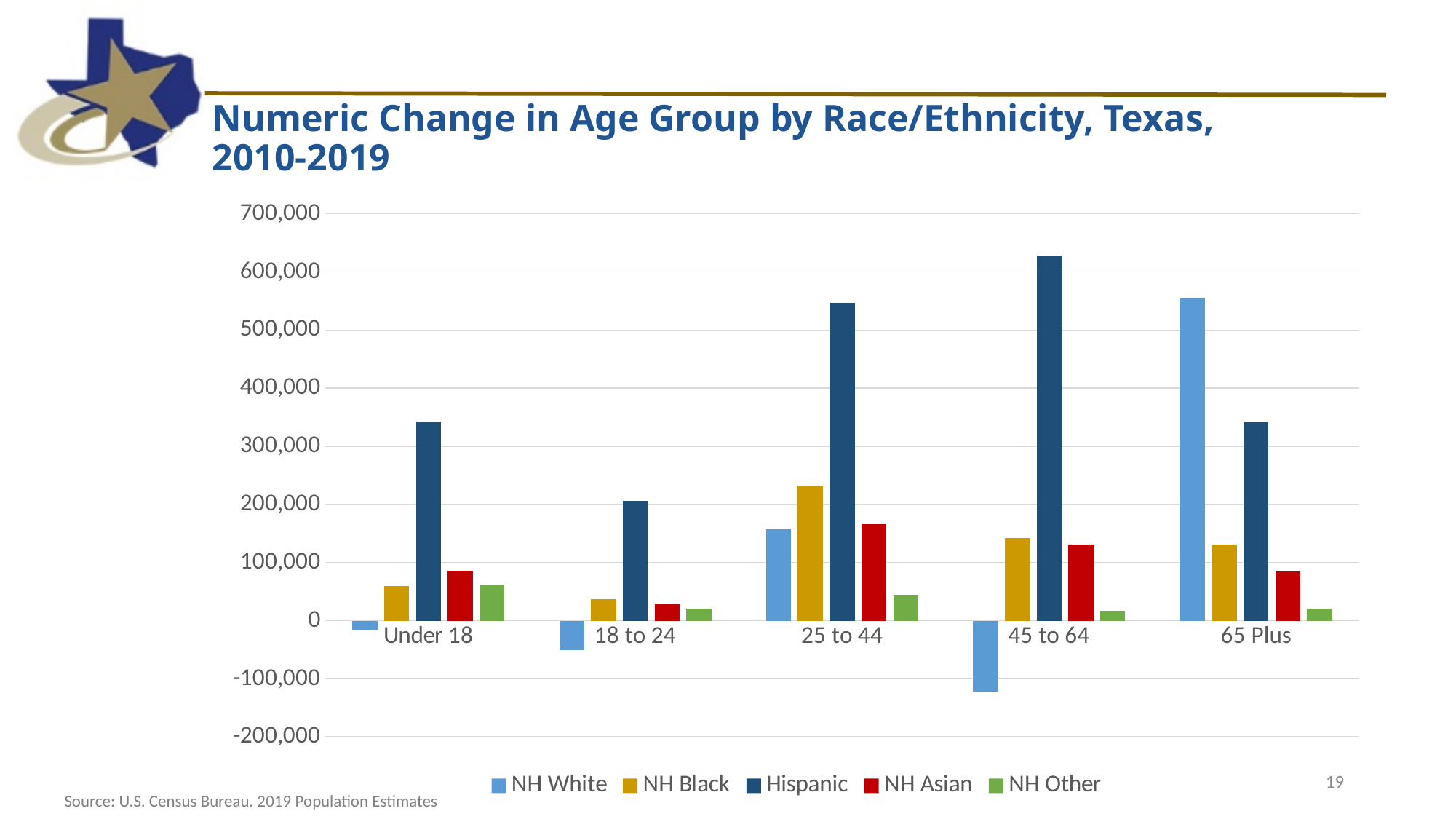
Is the NH White value for 45 to 64 greater or less than -100,000? less How many series does the legend list? 5 Is the NH White value for 65 Plus greater or less than 500,000? greater In the 25 to 44 age group, which is larger: NH Black or NH Asian? NH Black In which age group is the NH White bar the lowest? 45 to 64 Which series is shown in red? NH Asian How many age groups are shown on the x axis? 5 What kind of chart is shown on the slide? Bar chart Is the Hispanic value for 25 to 44 greater or less than 500,000? greater In which age group is the Hispanic bar the highest? 45 to 64 In the 65 Plus age group, which is larger: NH White or Hispanic? NH White